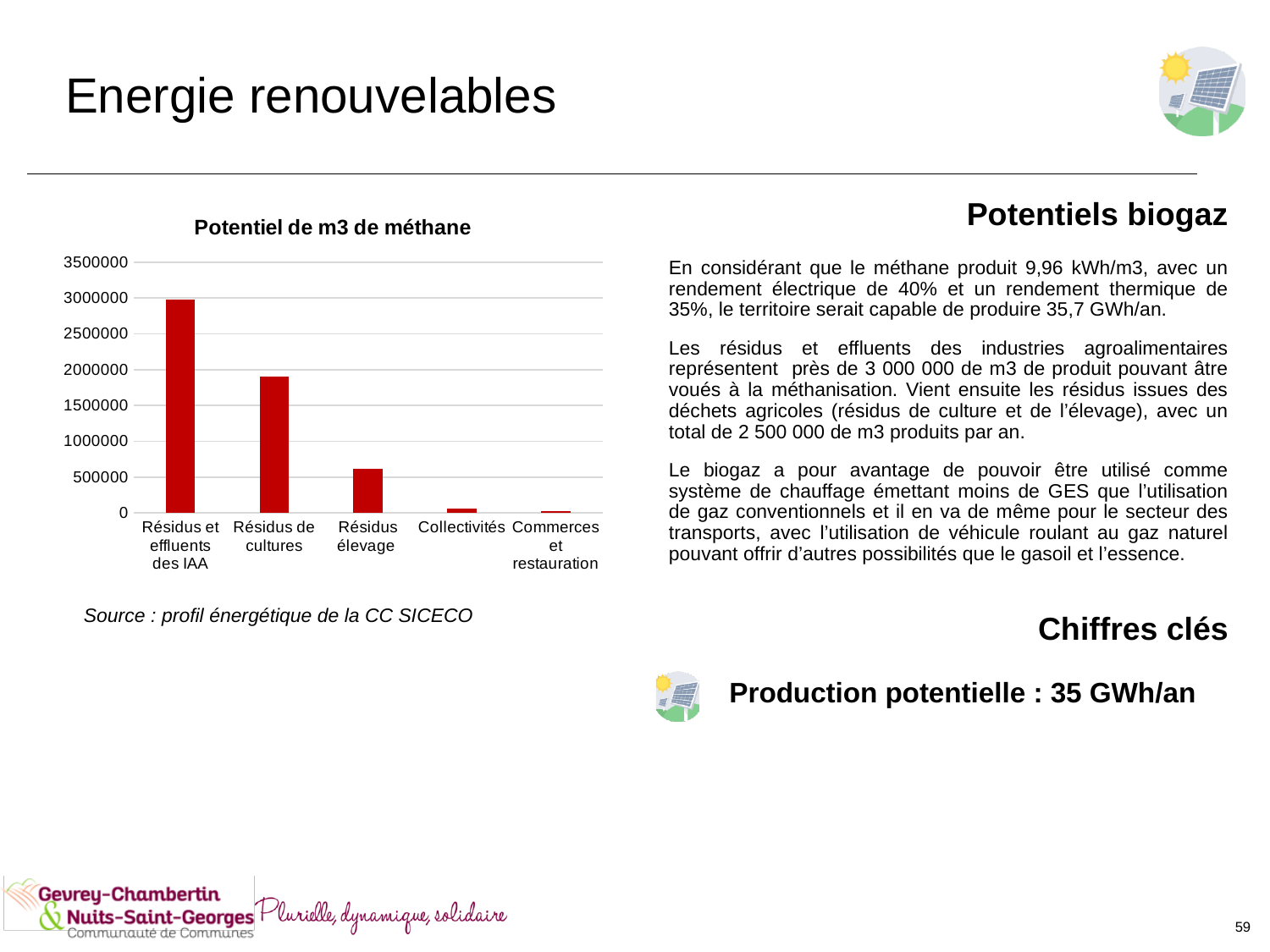
What is the title of the chart? Potentiel de m3 de méthane Is the value for Collectivités greater or less than 500000? less What colour are the bars in the chart? red Which is larger, the value for Résidus de cultures or the value for Résidus élevage? Résidus de cultures What kind of chart is shown on the slide? bar chart Which category has the lowest value in the chart? Commerces et restauration Is the value for Résidus élevage greater or less than 1000000? less How many categories are shown on the x axis of the chart? 5 Is the value for Résidus et effluents des IAA greater or less than 2500000? greater Which category has the highest value in the chart? Résidus et effluents des IAA Do the values rise or fall from left to right along the x axis? fall